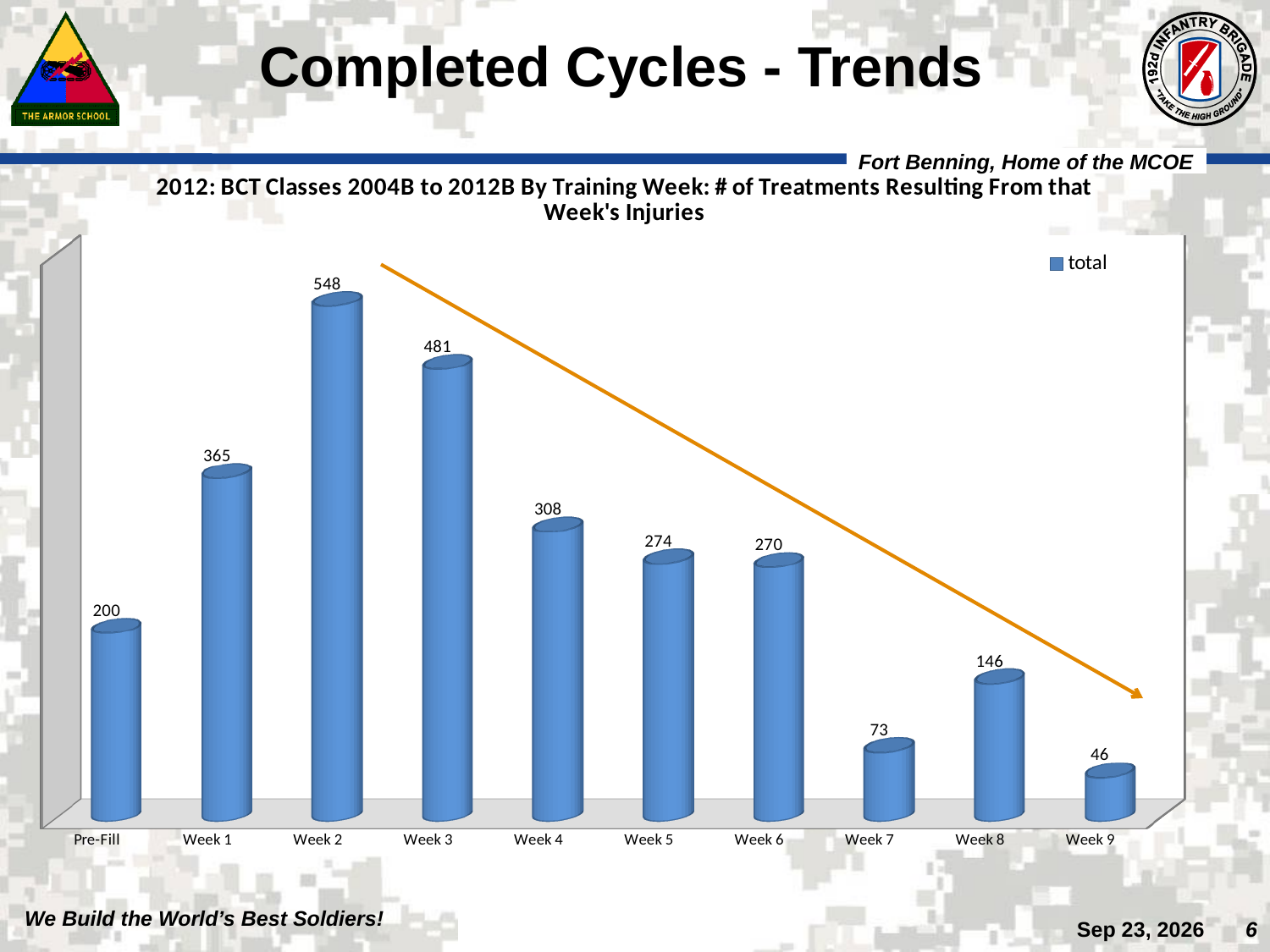
What is the name of the series listed in the legend? total Which training week has the lowest number of treatments? Week 9 What is the value for Week 2? 548 Which training week has the highest number of treatments? Week 2 How many series does the legend list? 1 Which is larger, the value for Week 1 or the value for Week 4? Week 1 What is the difference between the values for Week 8 and Week 7? 73 What is the value for Week 9? 46 What is the difference between the values for Week 2 and Week 3? 67 How many categories are shown on the x axis? 10 What kind of chart is shown on the slide? Bar chart What is the value for Pre-Fill? 200